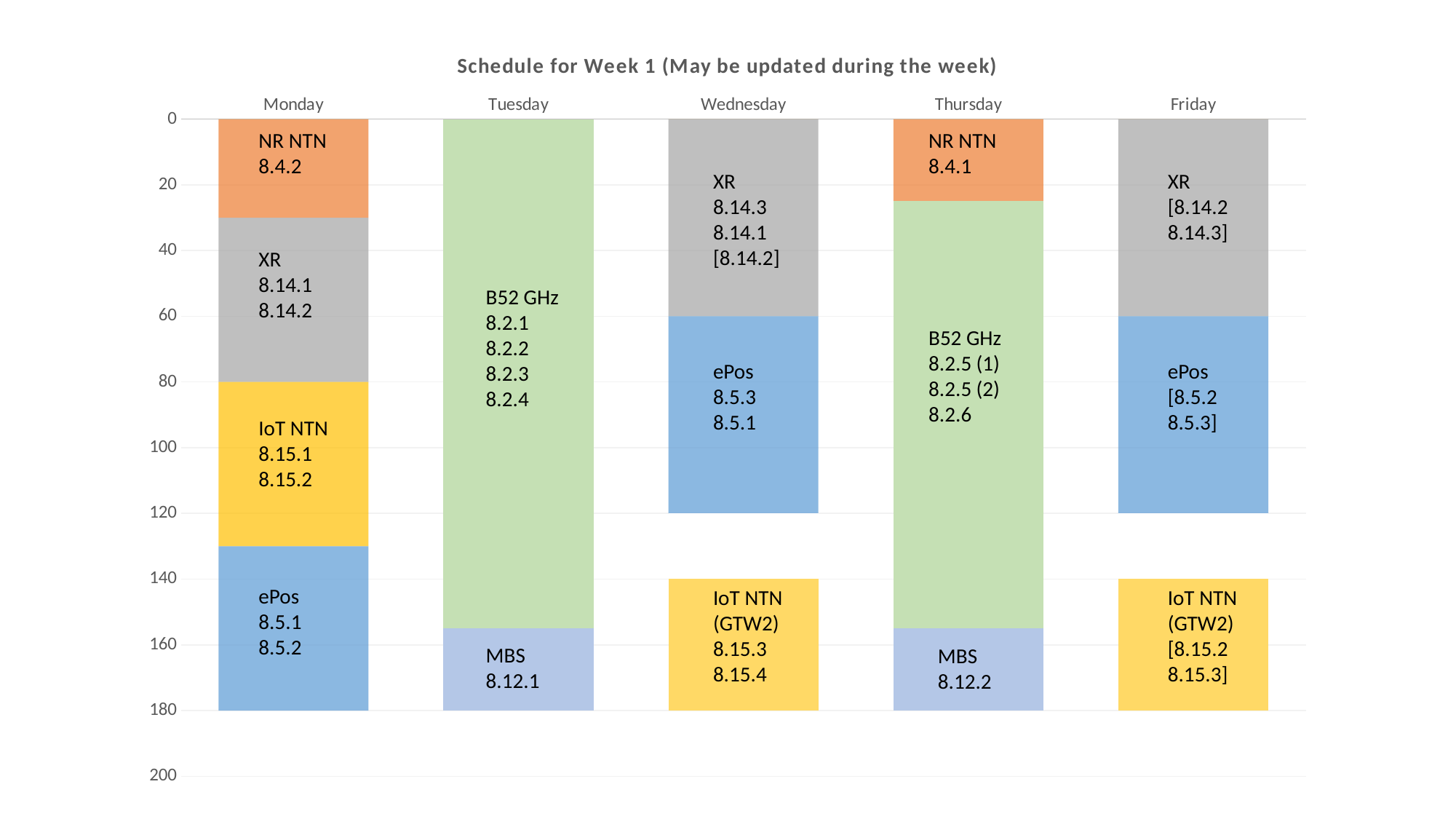
At what axis value does the XR segment on Monday end? 80 Which days have an empty gap in their bar between the ePos and IoT NTN segments? Wednesday and Friday On which day is B52 GHz 8.2.5 scheduled? Thursday Which segment on Monday is the smallest? NR NTN 8.4.2 On which day is MBS 8.12.2 scheduled? Thursday Which session is scheduled at the bottom of the Tuesday bar? MBS 8.12.1 What is the title of the chart? Schedule for Week 1 (May be updated during the week) At what axis value does the IoT NTN (GTW2) segment on Friday start? 140 What kind of chart is shown on the slide? Stacked bar chart At what axis value does the ePos segment on Wednesday end? 120 How many days (categories) are shown along the x axis? 5 On Tuesday, which segment is larger: B52 GHz or MBS? B52 GHz